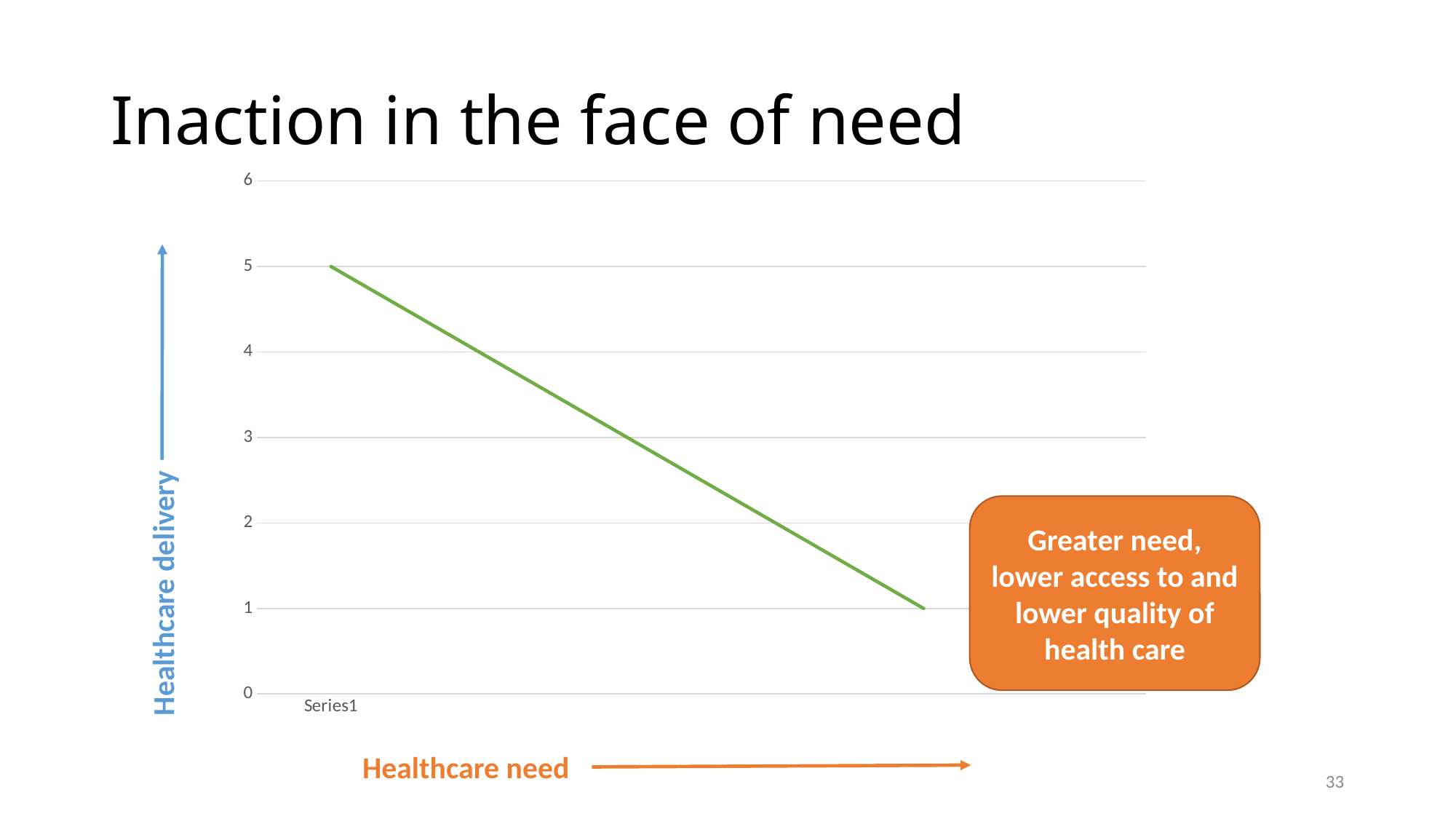
Is the value at the right end of the line greater or less than 3? less Which is larger, the value at the left end of the line or the value at the right end? left end What is the category label shown under the x axis? Series1 Does the green line rise or fall as it moves from left to right along the x axis? fall What is the highest value shown on the vertical axis? 6 Is the value at the left end of the line greater or less than 4? greater What label is written along the vertical axis of the chart? Healthcare delivery What kind of chart is shown on the slide? line chart What is the difference between the starting value and the ending value of the green line? 4 What value does the green line end at on the right end? 1 What value does the green line start at on the left end? 5